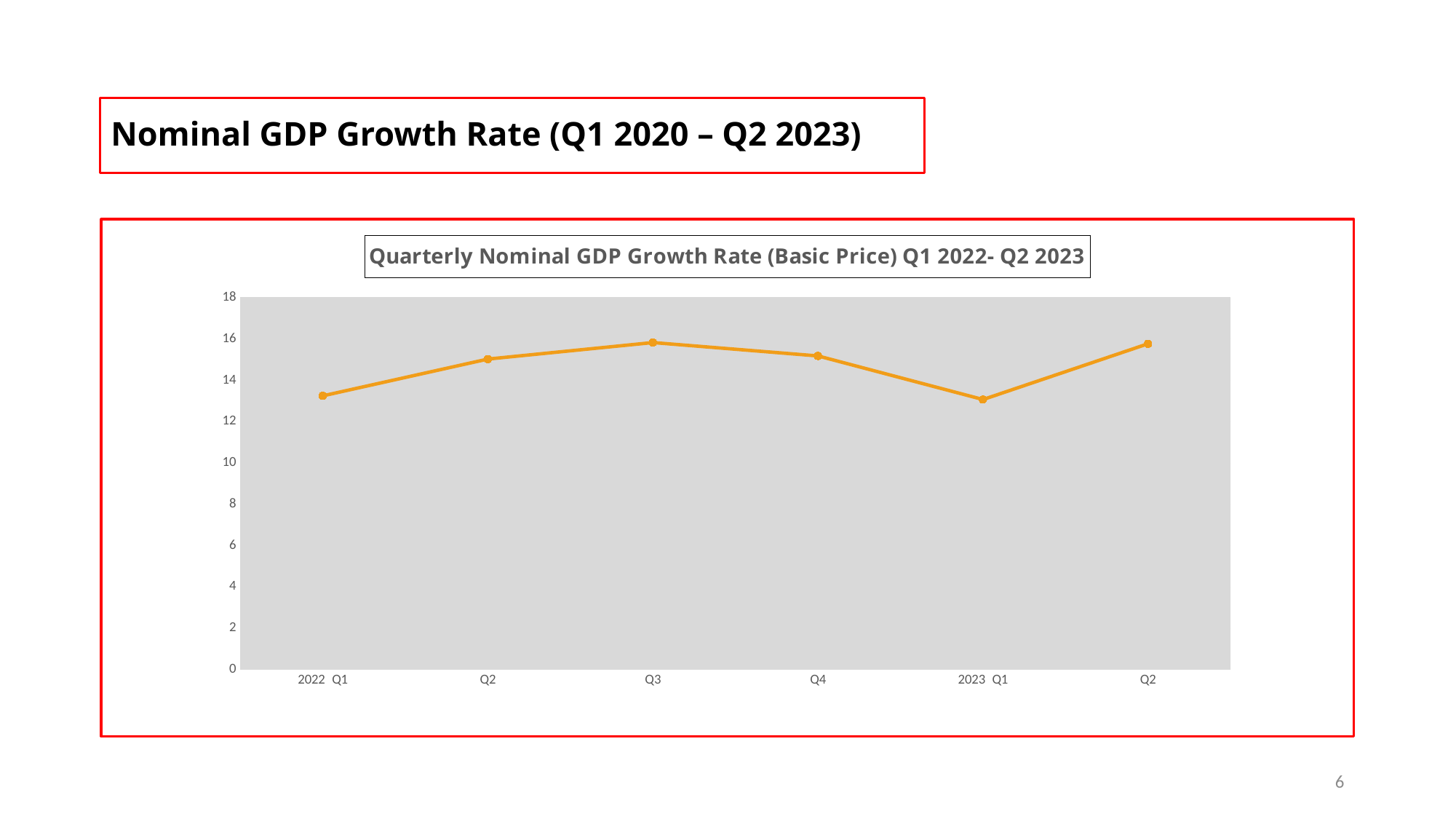
What is the title of the chart? Quarterly Nominal GDP Growth Rate (Basic Price) Q1 2022- Q2 2023 Does the growth rate rise or fall from 2022 Q1 to 2022 Q3? rise Does the growth rate rise or fall from 2022 Q4 to 2023 Q1? fall Which is larger, the value for 2022 Q4 or the value for 2023 Q1? 2022 Q4 Is the value for 2022 Q1 greater or less than 14? less What kind of chart is shown on the slide? line chart Is the value for 2023 Q1 greater or less than 14? less Is the value for 2022 Q2 greater or less than 14? greater How many quarters are plotted on the chart? 6 Which is larger, the value for 2022 Q3 or the value for 2022 Q1? 2022 Q3